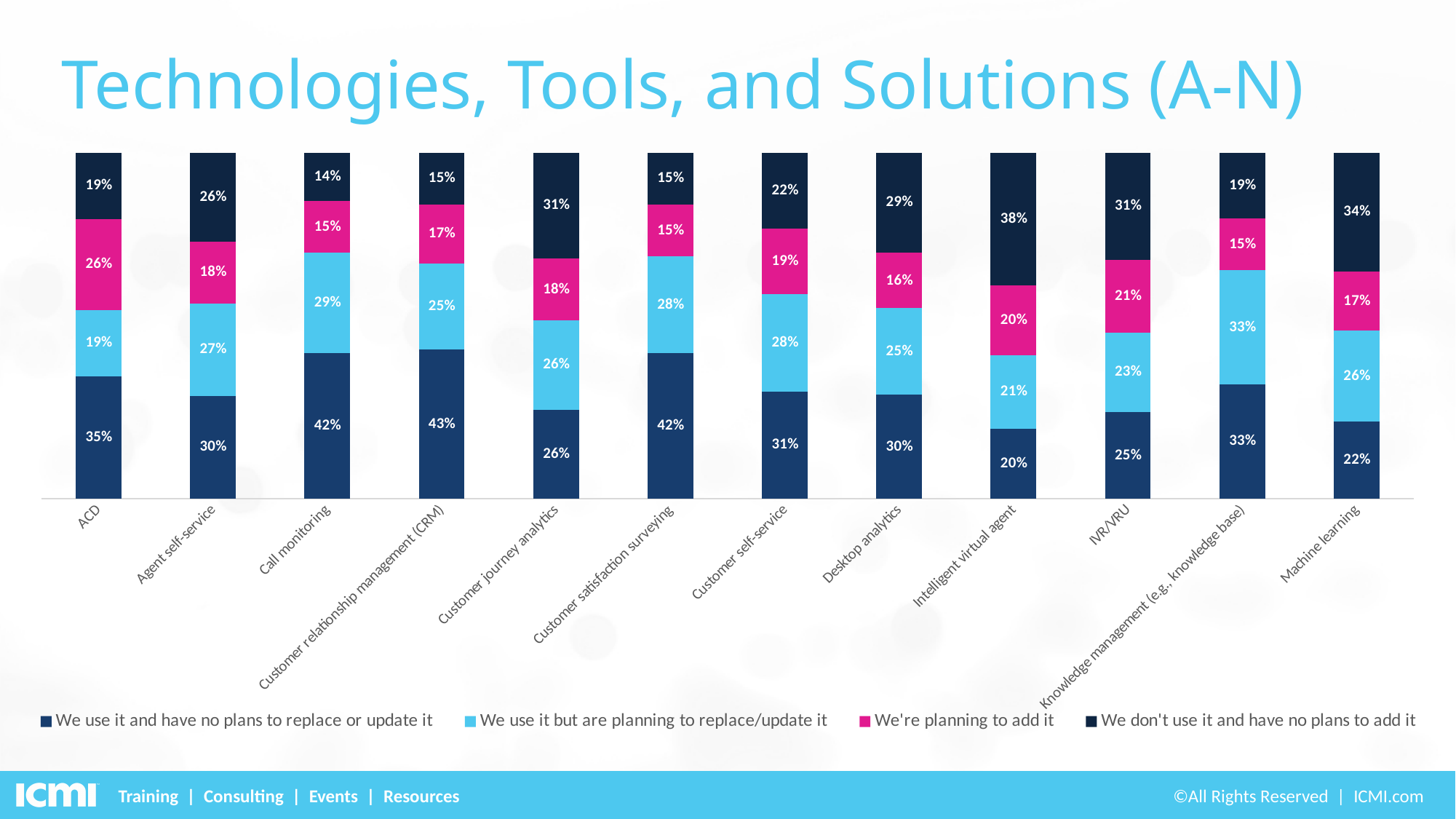
Which is larger: the 'We use it but are planning to replace/update it' value for Knowledge management (e.g., knowledge base) or for ACD? Knowledge management (e.g., knowledge base) What is the value for 'We're planning to add it' for IVR/VRU? 21% Which category has the highest value for 'We use it and have no plans to replace or update it'? Customer relationship management (CRM) How many series does the legend list? 4 How many technology categories are shown along the x axis? 12 What is the difference between the 'We use it and have no plans to replace or update it' values for Call monitoring and Machine learning? 20% Which category has the highest value for 'We're planning to add it'? ACD Which category has the lowest value for 'We don't use it and have no plans to add it'? Call monitoring What colour represents 'We're planning to add it' in the legend? Pink What kind of chart is shown on the slide? Stacked bar chart What is the value for 'We don't use it and have no plans to add it' for Intelligent virtual agent? 38% What is the value for 'We use it and have no plans to replace or update it' for Customer relationship management (CRM)? 43%